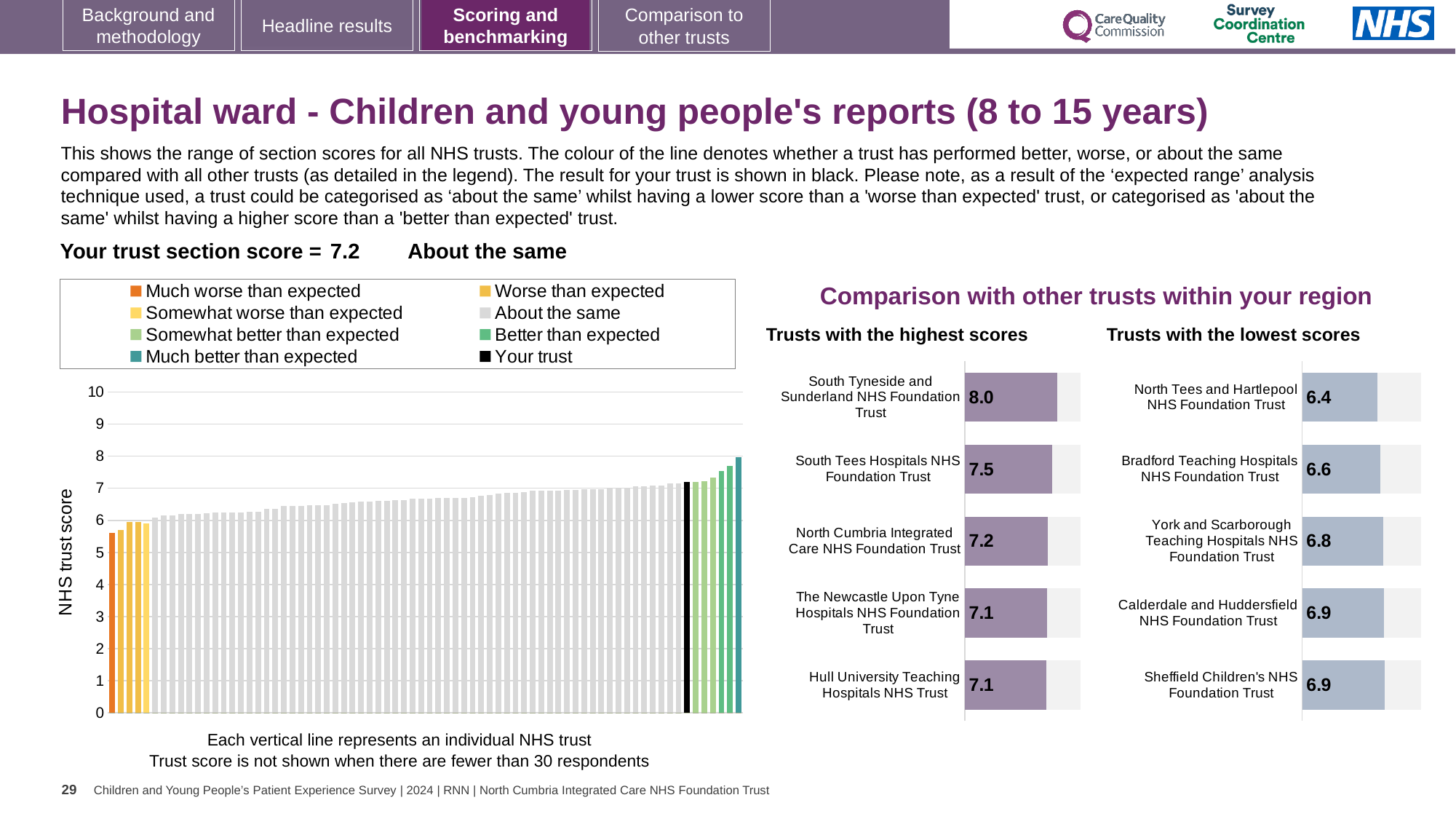
In the 'Trusts with the lowest scores' chart, which has the larger score: York and Scarborough Teaching Hospitals NHS Foundation Trust or North Tees and Hartlepool NHS Foundation Trust? York and Scarborough Teaching Hospitals NHS Foundation Trust In the large chart on the left showing all NHS trusts, how many entries does the legend list? 8 In the 'Trusts with the highest scores' chart, how many trusts are listed? 5 In the 'Trusts with the highest scores' chart, what is the score for South Tyneside and Sunderland NHS Foundation Trust? 8.0 What is the y-axis label of the large chart on the left showing all NHS trusts? NHS trust score In the large chart on the left showing all NHS trusts, is the value of the leftmost (orange) bar greater or less than 6? less In the 'Trusts with the lowest scores' chart, what is the score for Bradford Teaching Hospitals NHS Foundation Trust? 6.6 In the 'Trusts with the lowest scores' chart, which trust has the lowest score? North Tees and Hartlepool NHS Foundation Trust In the large chart on the left showing all NHS trusts, do the bar values rise or fall from left to right? Rise In the 'Trusts with the highest scores' chart, what is the difference between the scores of South Tyneside and Sunderland NHS Foundation Trust and South Tees Hospitals NHS Foundation Trust? 0.5 In the 'Trusts with the highest scores' chart, which trust has the highest score? South Tyneside and Sunderland NHS Foundation Trust What kind of chart is the large chart on the left showing all NHS trusts? Bar chart